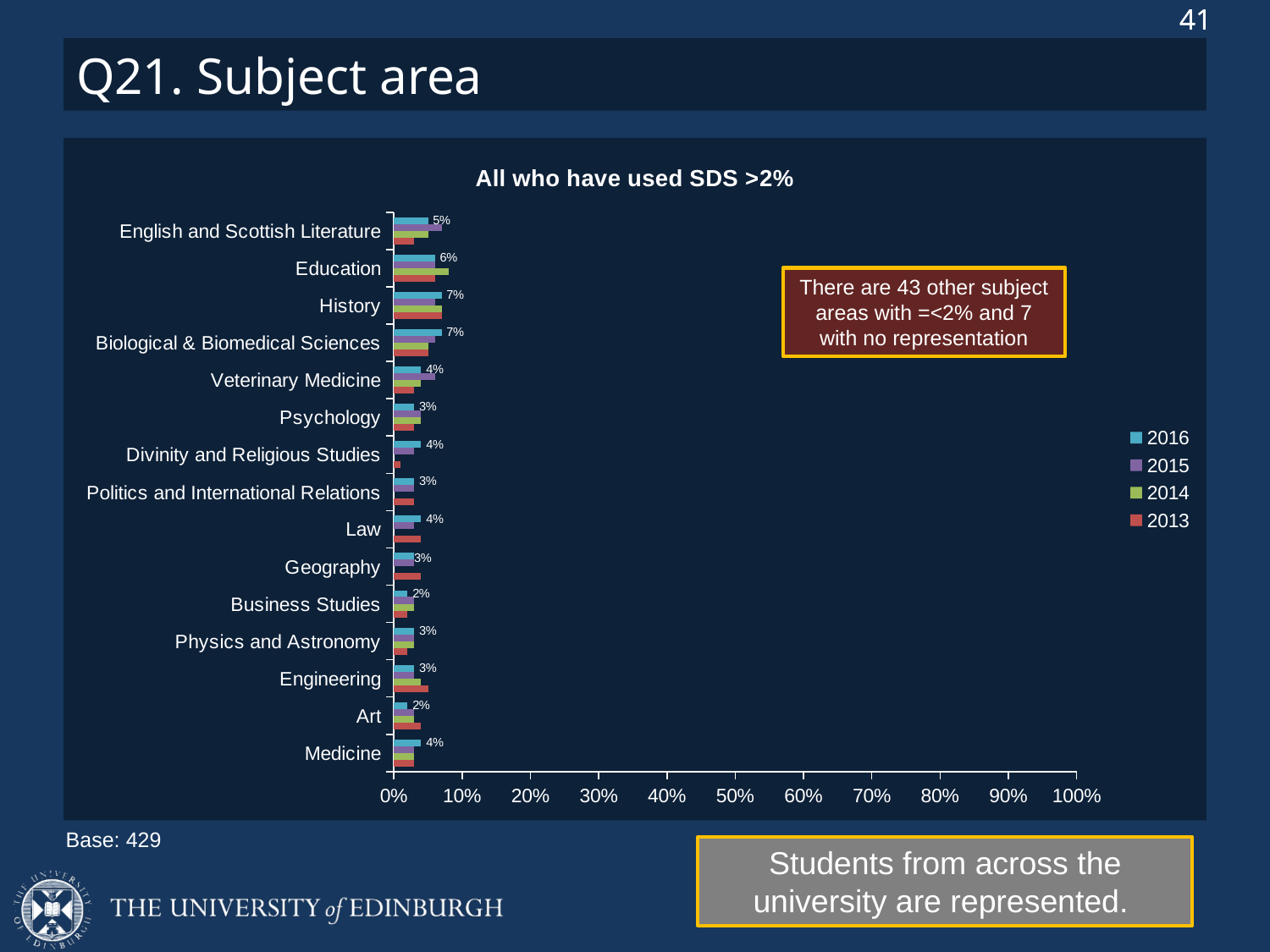
How many subject areas are shown on the chart? 15 What is the 2016 value for English and Scottish Literature? 5% What is the 2016 value for Medicine? 4% What is the 2016 value for History? 7% What is the title of the chart? All who have used SDS >2% How many series does the legend list? 4 What kind of chart is shown on the slide? Bar chart Is the 2015 value for Education greater or less than 10%? less Which has the larger 2016 value, History or Psychology? History What is the difference between the 2016 values for Education and Business Studies? 4 percentage points What is the 2016 value for Education? 6% What is the 2016 value for Business Studies? 2%